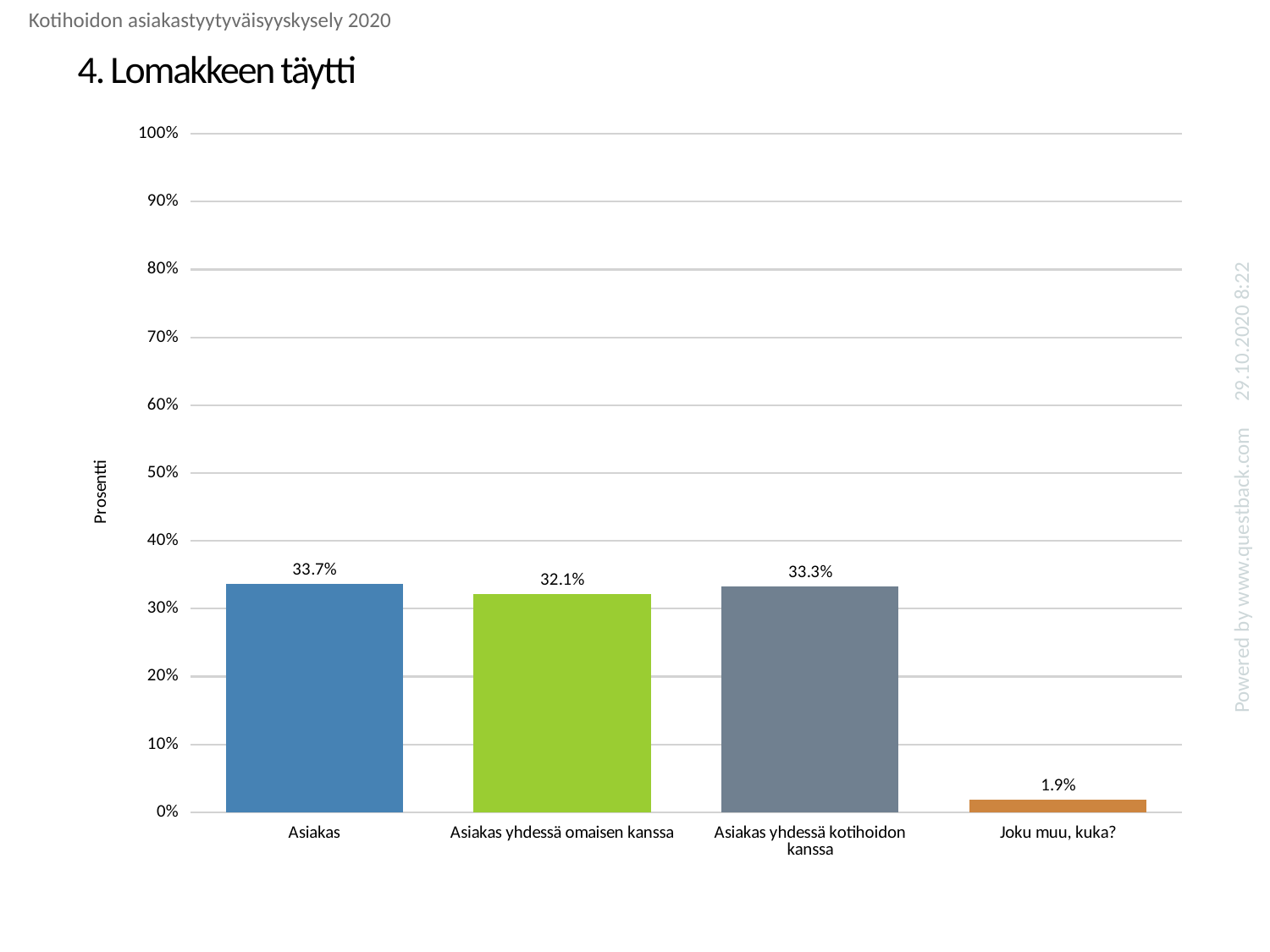
What is the difference between the values for Asiakas and Asiakas yhdessä omaisen kanssa? 1.6% How many categories are shown on the x axis? 4 What is the title of the chart? 4. Lomakkeen täytti What is the difference between the values for Asiakas yhdessä kotihoidon kanssa and Joku muu, kuka? 31.4% Which category has the highest value? Asiakas Which is larger, the value for Asiakas yhdessä omaisen kanssa or the value for Joku muu, kuka? Asiakas yhdessä omaisen kanssa What is the value for Asiakas yhdessä omaisen kanssa? 32.1% What is the value for Asiakas yhdessä kotihoidon kanssa? 33.3% What is the value for Asiakas? 33.7% What kind of chart is shown on the slide? Bar chart Which category has the lowest value? Joku muu, kuka? What is the value for Joku muu, kuka? 1.9%